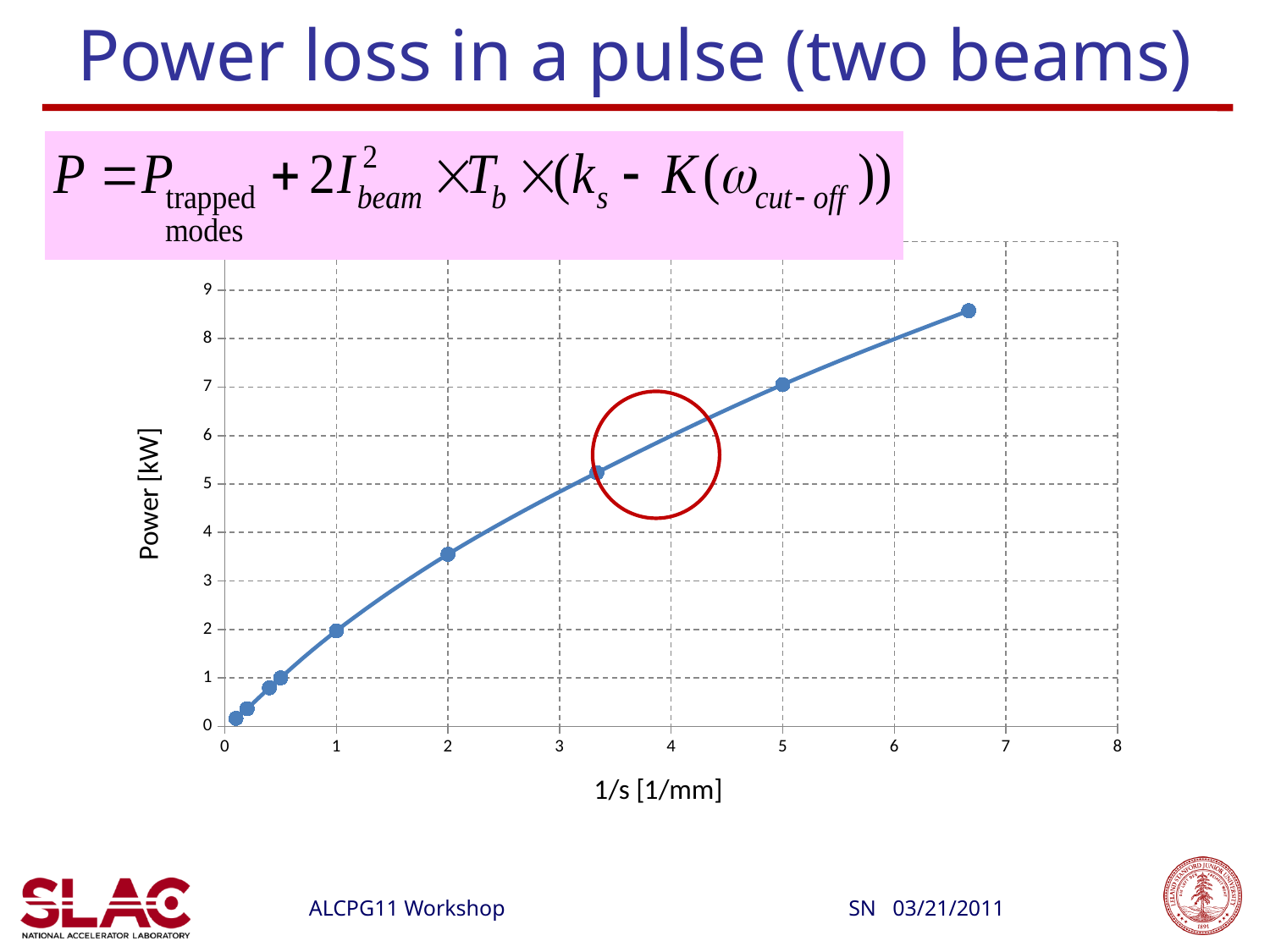
What kind of chart is shown on the slide? line chart Do the plotted power values rise or fall as 1/s increases along the x axis? rise Which data point has the highest power value, the one at 1/s = 5 or the one near 1/s = 6.7? the one near 1/s = 6.7 What is the label of the x axis? 1/s [1/mm] Is the power value at 1/s = 2 greater or less than 3 kW? greater How many data points are plotted on the curve? 9 Is the power value at 1/s = 1 greater or less than 3 kW? less Is the power value at 1/s = 5 greater or less than 6 kW? greater What is the label of the y axis? Power [kW] Which data point has the lowest power value, the one nearest 1/s = 0 or the one at 1/s = 1? the one nearest 1/s = 0